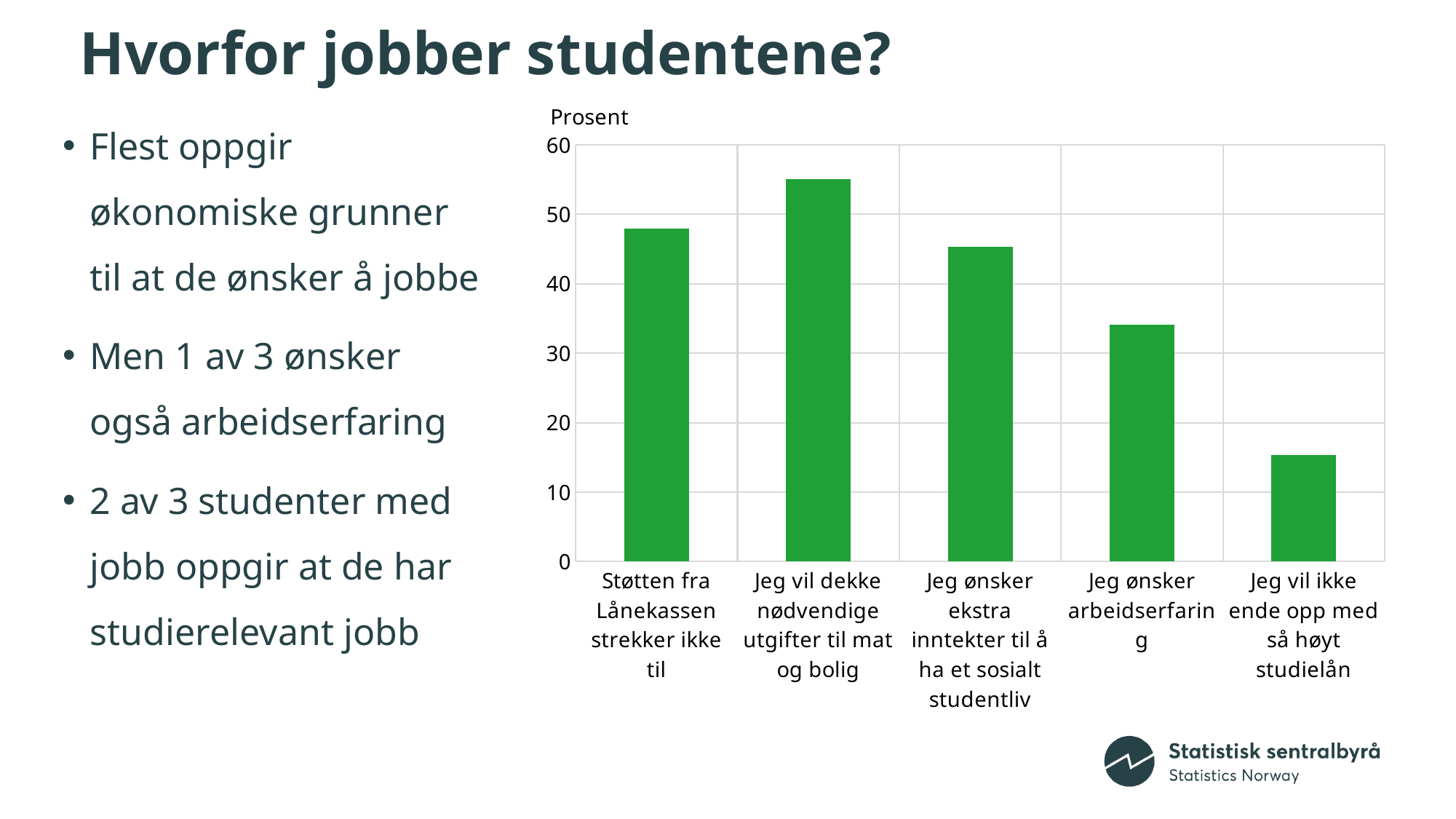
What label is shown above the vertical axis of the chart? Prosent Is the value for "Jeg ønsker arbeidserfaring" greater or less than 30? greater What colour are the bars in the chart? green Which is larger: the value for "Jeg ønsker arbeidserfaring" or the value for "Jeg vil ikke ende opp med så høyt studielån"? Jeg ønsker arbeidserfaring Which category has the highest value? Jeg vil dekke nødvendige utgifter til mat og bolig Is the value for "Jeg ønsker ekstra inntekter til å ha et sosialt studentliv" greater or less than 50? less Is the value for "Støtten fra Lånekassen strekker ikke til" greater or less than 40? greater How many categories (bars) does the chart show? 5 Which category has the lowest value? Jeg vil ikke ende opp med så høyt studielån What kind of chart is shown on the slide? bar chart